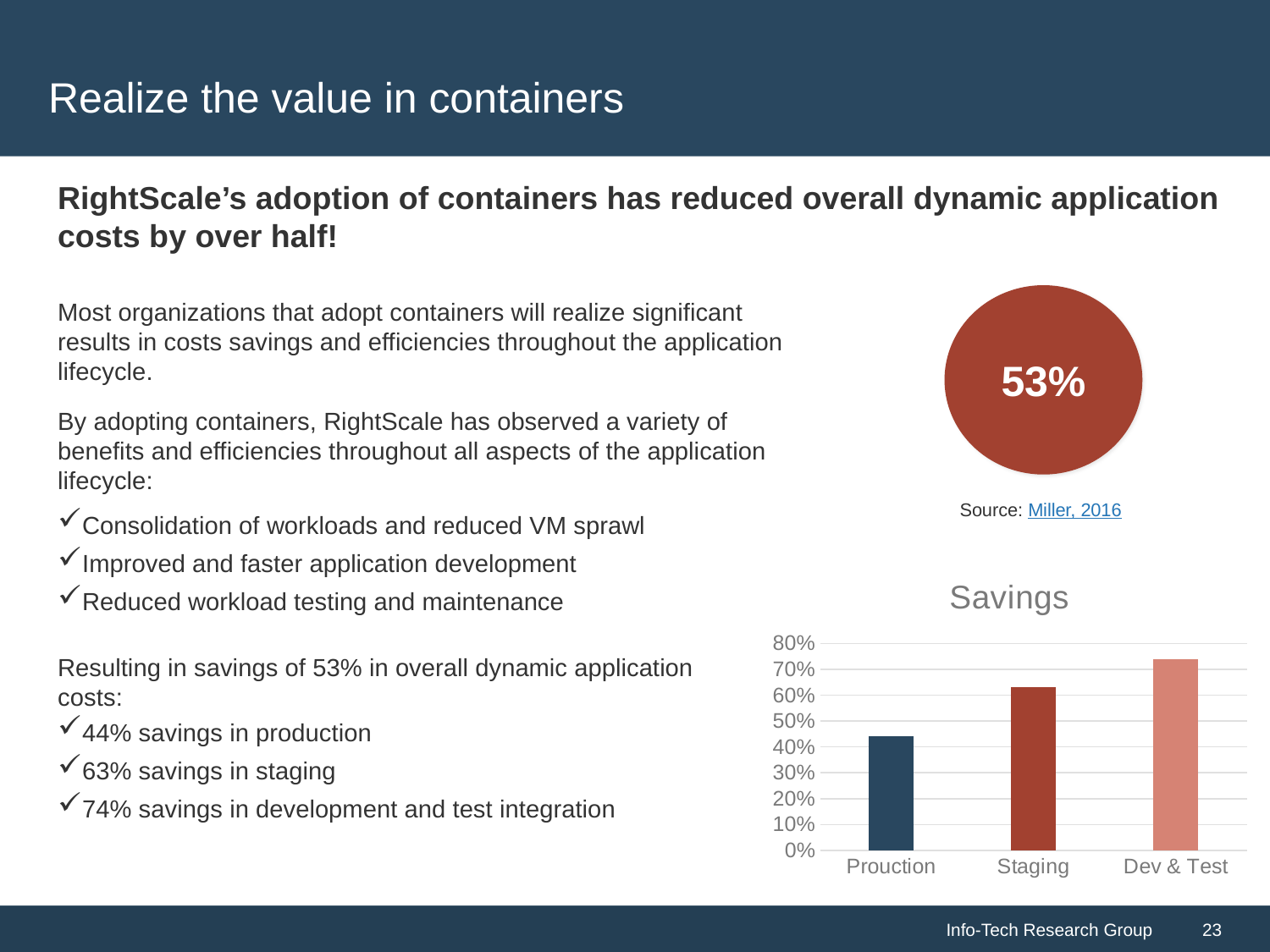
How many categories are shown on the x axis of the "Savings" chart? 3 Do the bars in the "Savings" chart rise or fall from left to right? rise In the "Savings" chart, is the value for Staging greater or less than 60%? greater What is the title of the bar chart on the slide? Savings In the "Savings" chart, is the value for Prouction greater or less than 40%? greater Which category has the highest bar in the "Savings" chart? Dev & Test What kind of chart is the "Savings" chart? bar chart Which category has the lowest bar in the "Savings" chart? Prouction In the "Savings" chart, is the value for Prouction greater or less than 50%? less In the "Savings" chart, which is larger, the value for Staging or the value for Prouction? Staging